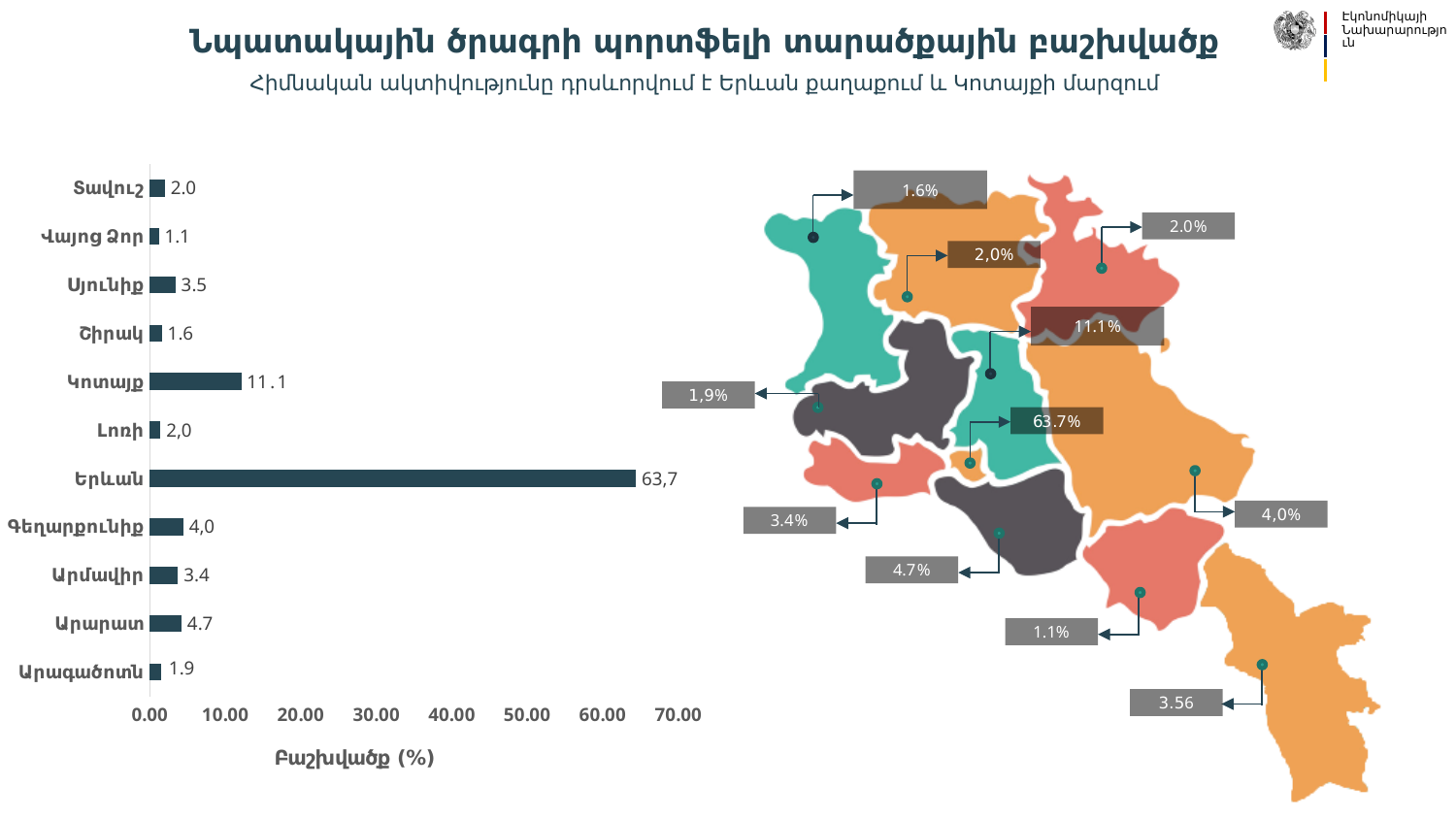
Is the value for Երևան in the bar chart greater or less than 60.00? greater What is the value for Վայոց Ձոր in the bar chart? 1.1 Which category has the lowest value in the bar chart? Վայոց Ձոր What is the value for Երևան in the bar chart? 63,7 Which has a larger value in the bar chart, Սյունիք or Արմավիր? Սյունիք What type of chart is shown on the left of the slide? bar chart What is the value for Կոտայք in the bar chart? 11.1 What is the label of the horizontal axis of the bar chart? Բաշխվածք (%) What is the difference between the values for Կոտայք and Արարատ in the bar chart? 6.4 What is the value for Արարատ in the bar chart? 4.7 Which category has the highest value in the bar chart? Երևան How many categories are shown in the bar chart? 11